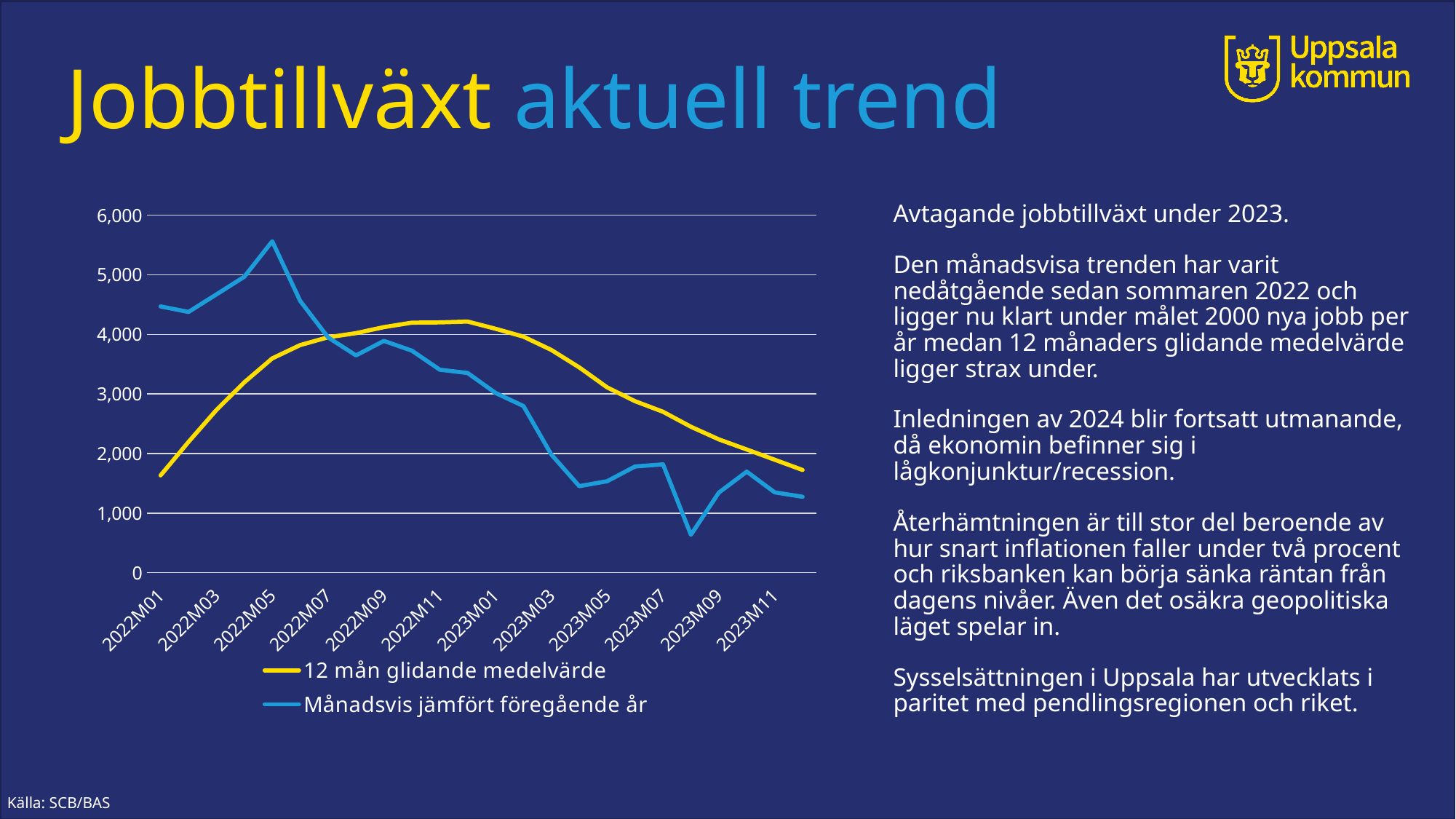
How many series does the chart legend list? 2 What colour is the line for '12 mån glidande medelvärde'? Yellow Is the value of 'Månadsvis jämfört föregående år' at 2022M05 greater or less than 5,000? greater In which month does the 'Månadsvis jämfört föregående år' series reach its lowest value? 2023M08 At 2022M01, which series has the higher value: '12 mån glidande medelvärde' or 'Månadsvis jämfört föregående år'? Månadsvis jämfört föregående år What source is cited for the chart? SCB/BAS Does the '12 mån glidande medelvärde' line rise or fall from 2023M01 to 2023M11? Fall How many month labels are shown on the x axis? 12 In which month does the 'Månadsvis jämfört föregående år' series reach its highest value? 2022M05 What kind of chart is shown on the slide? Line chart Is the value of '12 mån glidande medelvärde' at 2022M01 greater or less than 2,000? less Is the value of 'Månadsvis jämfört föregående år' at 2023M09 greater or less than 1,000? greater